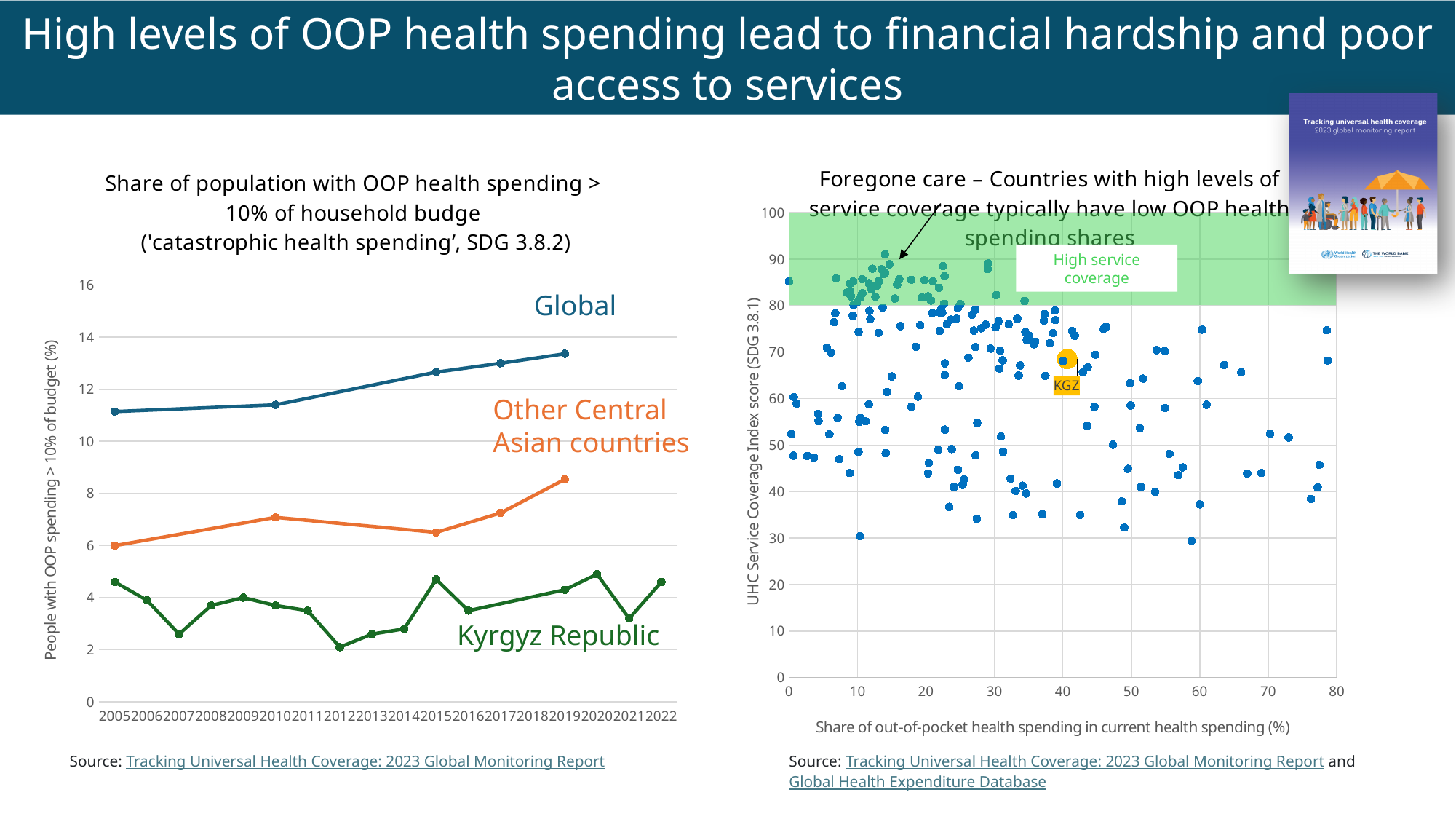
What kind of chart is the left chart, 'Share of population with OOP health spending > 10% of household budget'? line chart On the left chart, is the Global value for 2019 greater or less than 12? greater On the left chart, is the Kyrgyz Republic value for 2012 greater or less than 4? less On the left chart, is the Other Central Asian countries value for 2019 greater or less than 8? greater What kind of chart is the right chart, 'Foregone care'? scatter chart On the left chart, which series has the highest values throughout the period? Global On the left chart, which is larger in 2019: the Global value or the Kyrgyz Republic value? Global On the left chart, does the Global series rise or fall from 2005 to 2019? rise On the left chart, how many series are plotted? 3 On the left chart, which series has the lowest values throughout the period? Kyrgyz Republic On the left chart, how many data points does the Kyrgyz Republic series have? 16